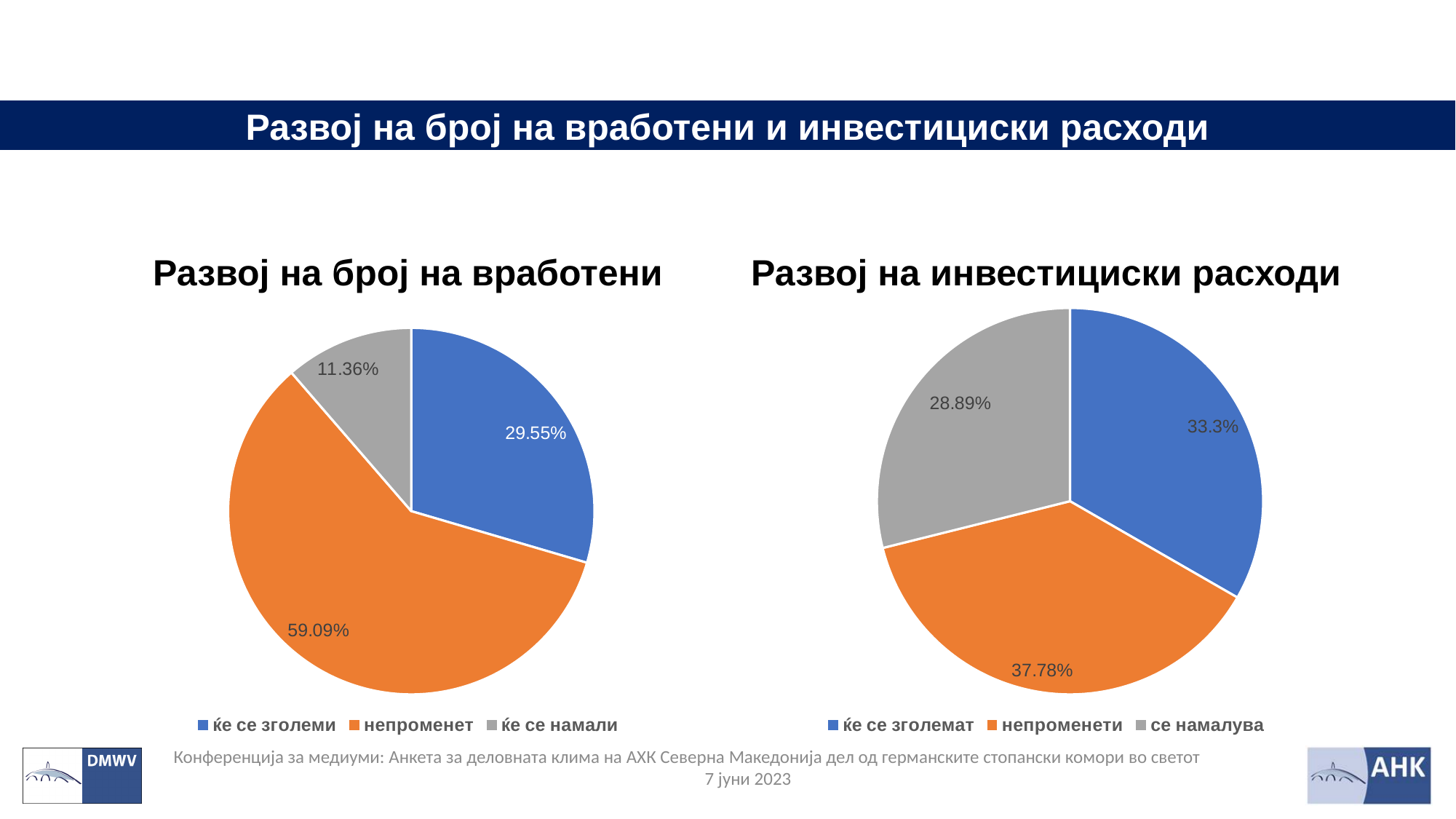
In the chart titled "Развој на инвестициски расходи", what share is labelled for "непроменети"? 37.78% In the chart titled "Развој на број на вработени", which category has the largest slice? непроменет In the chart titled "Развој на број на вработени", what share is labelled for "ќе се намали"? 11.36% In the chart titled "Развој на број на вработени", what share is labelled for "непроменет"? 59.09% In the chart titled "Развој на инвестициски расходи", which category has the smallest slice? се намалува What type of chart is the chart titled "Развој на број на вработени"? Pie chart In the chart titled "Развој на инвестициски расходи", what share is labelled for "се намалува"? 28.89% How many categories does the legend of the chart titled "Развој на инвестициски расходи" list? 3 In the chart titled "Развој на инвестициски расходи", what share is labelled for "ќе се зголемат"? 33.3% In the chart titled "Развој на број на вработени", what is the difference between the shares for "непроменет" and "ќе се зголеми"? 29.54% In the chart titled "Развој на инвестициски расходи", which is larger: the share for "ќе се зголемат" or the share for "се намалува"? ќе се зголемат In the chart titled "Развој на број на вработени", what share is labelled for "ќе се зголеми"? 29.55%